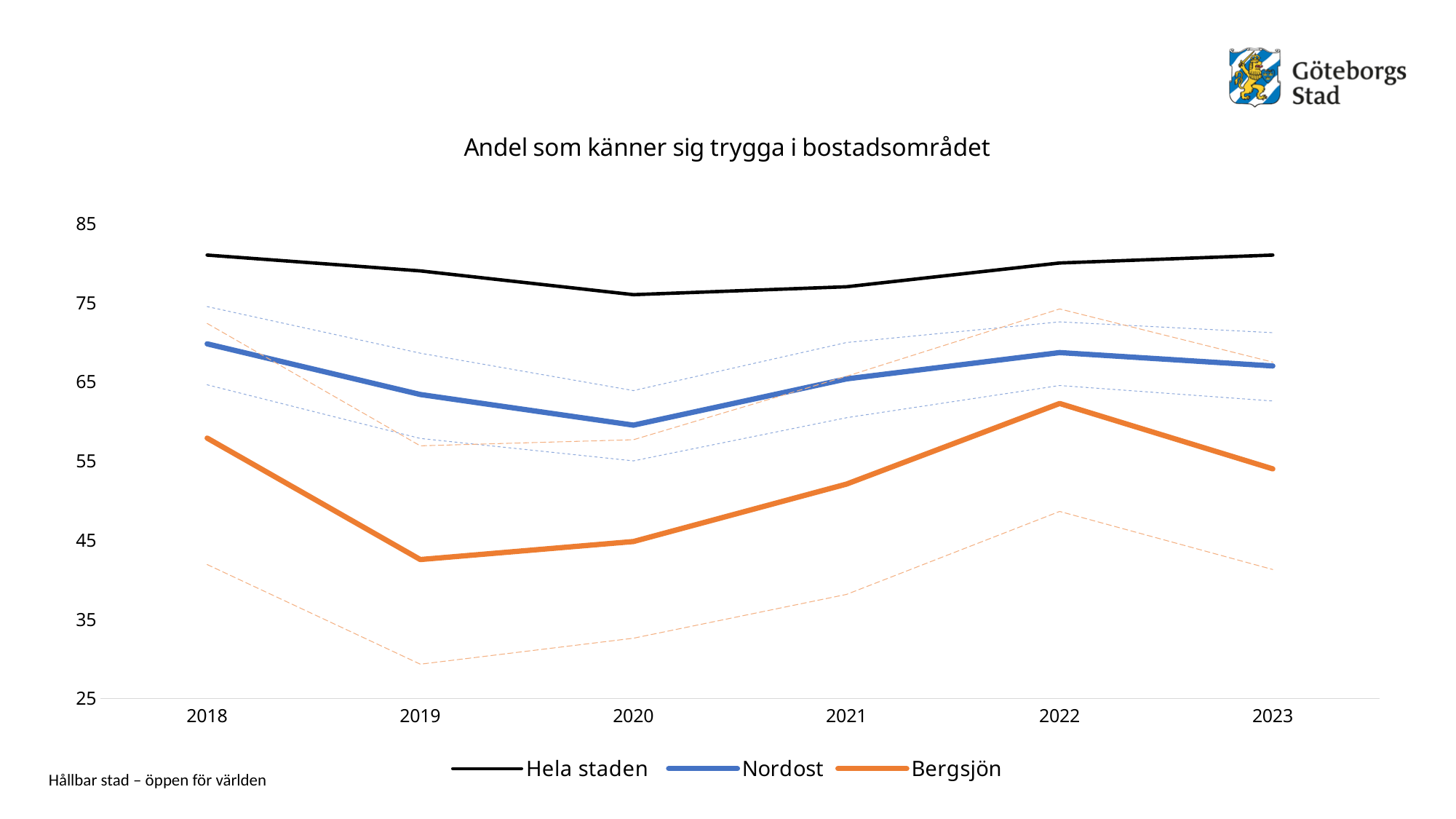
In which year is the value for Bergsjön highest? 2022 How many series does the legend list? 3 How many years are shown on the x axis? 6 In which year is the value for Bergsjön lowest? 2019 Does the value for Bergsjön rise or fall from 2019 to 2022? rise What kind of chart is shown on the slide? Line chart Which is larger in 2022, Nordost or Bergsjön? Nordost What is the title of the chart? Andel som känner sig trygga i bostadsområdet Is the value for Bergsjön in 2019 greater or less than 45? less Is the value for Hela staden in 2020 greater or less than 75? greater Which series is drawn in orange? Bergsjön In which year is the value for Nordost lowest? 2020